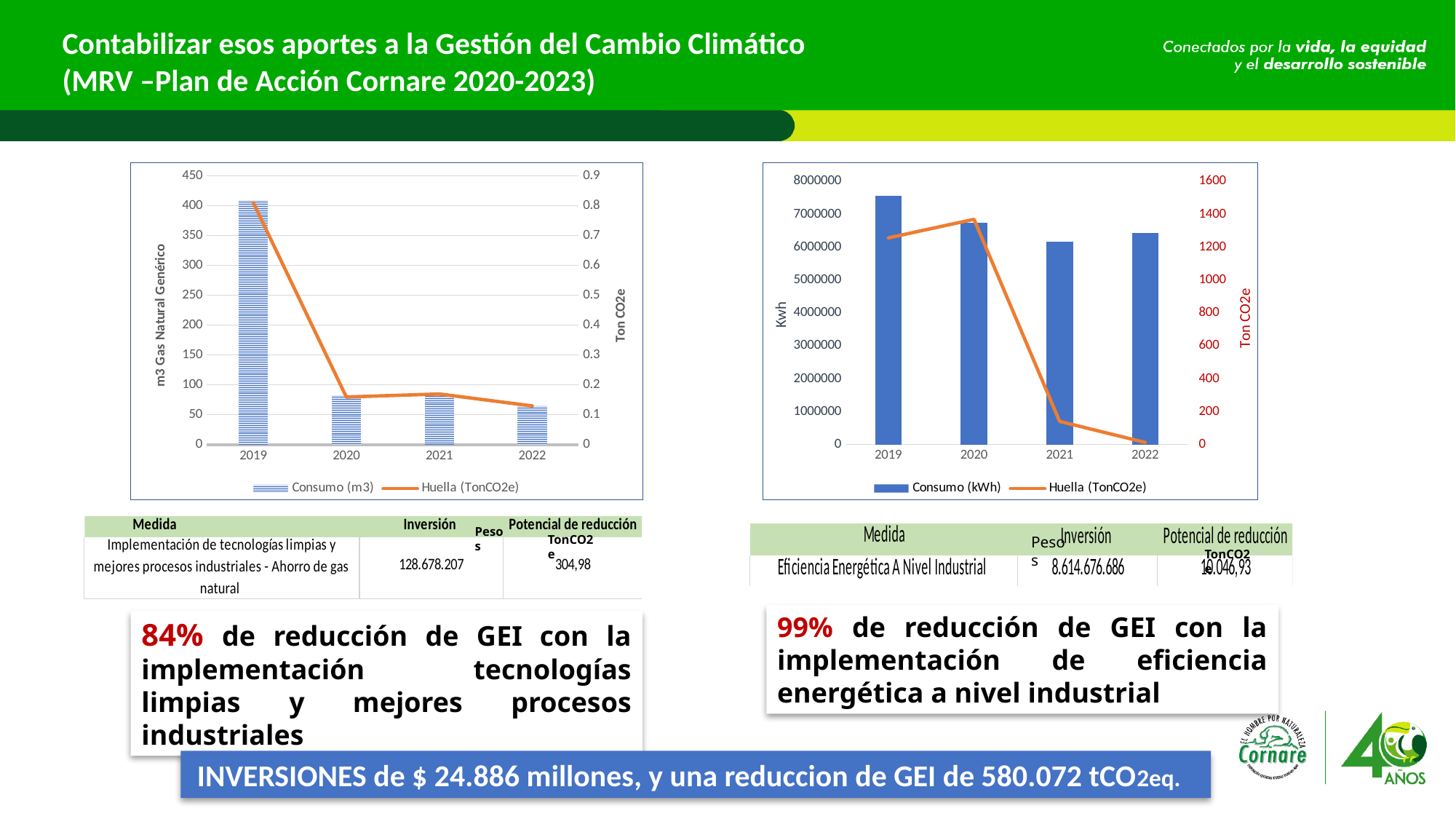
On the left chart (m3 Gas Natural Genérico), what is the title of the right-hand vertical axis? Ton CO2e On the right chart (Kwh), is the Consumo (kWh) value for 2019 greater or less than 7000000? greater On the left chart (m3 Gas Natural Genérico), how many series does the legend list? 2 On the right chart (Kwh), which is larger, the Huella (TonCO2e) value for 2020 or for 2021? 2020 On the right chart (Kwh), which year has the highest Consumo (kWh)? 2019 On the left chart (m3 Gas Natural Genérico), what kind of chart is used for the Consumo (m3) series? bar chart On the right chart (Kwh), does the Huella (TonCO2e) line rise or fall from 2020 to 2022? fall On the left chart (m3 Gas Natural Genérico), which year has the highest Consumo (m3)? 2019 On the left chart (m3 Gas Natural Genérico), is the Huella (TonCO2e) value for 2022 greater or less than 0.2? less On the left chart (m3 Gas Natural Genérico), how many years are shown on the x axis? 4 On the left chart (m3 Gas Natural Genérico), is the Consumo (m3) value for 2019 greater or less than 400? greater On the right chart (Kwh), which year has the lowest Huella (TonCO2e)? 2022